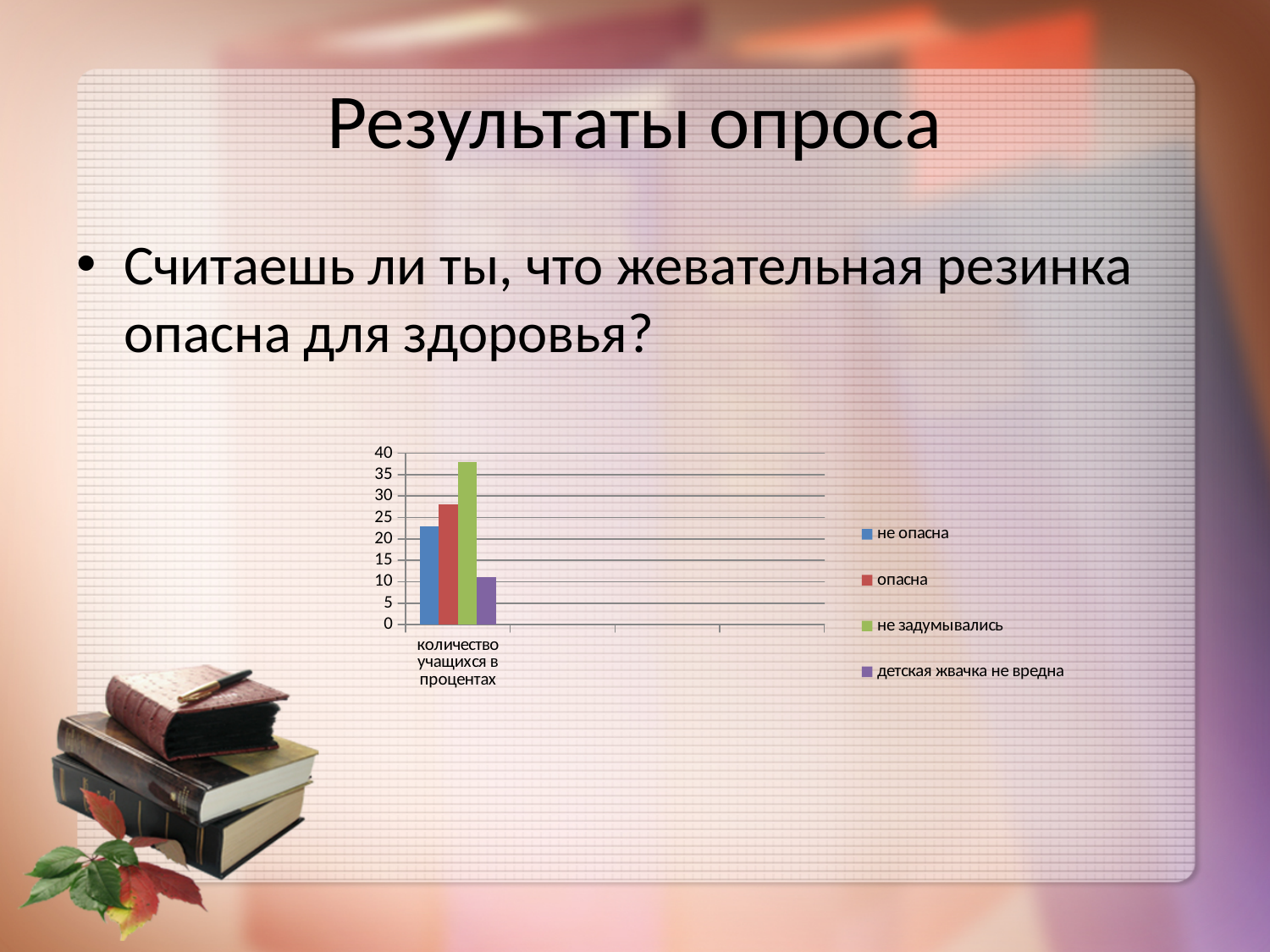
Is the value for "детская жвачка не вредна" greater or less than 15? less What is the label of the category on the x axis of the chart? количество учащихся в процентах Is the value for "не задумывались" greater or less than 35? greater Is the value for "опасна" greater or less than 30? less What kind of chart is shown on the slide? bar chart How many categories are shown on the x axis of the chart? 1 How many series does the chart legend list? 4 What colour is the bar for "не задумывались" in the chart? green Which is larger, the bar for "опасна" or the bar for "не опасна"? опасна Which series has the lowest bar in the chart? детская жвачка не вредна Which series has the highest bar in the chart? не задумывались